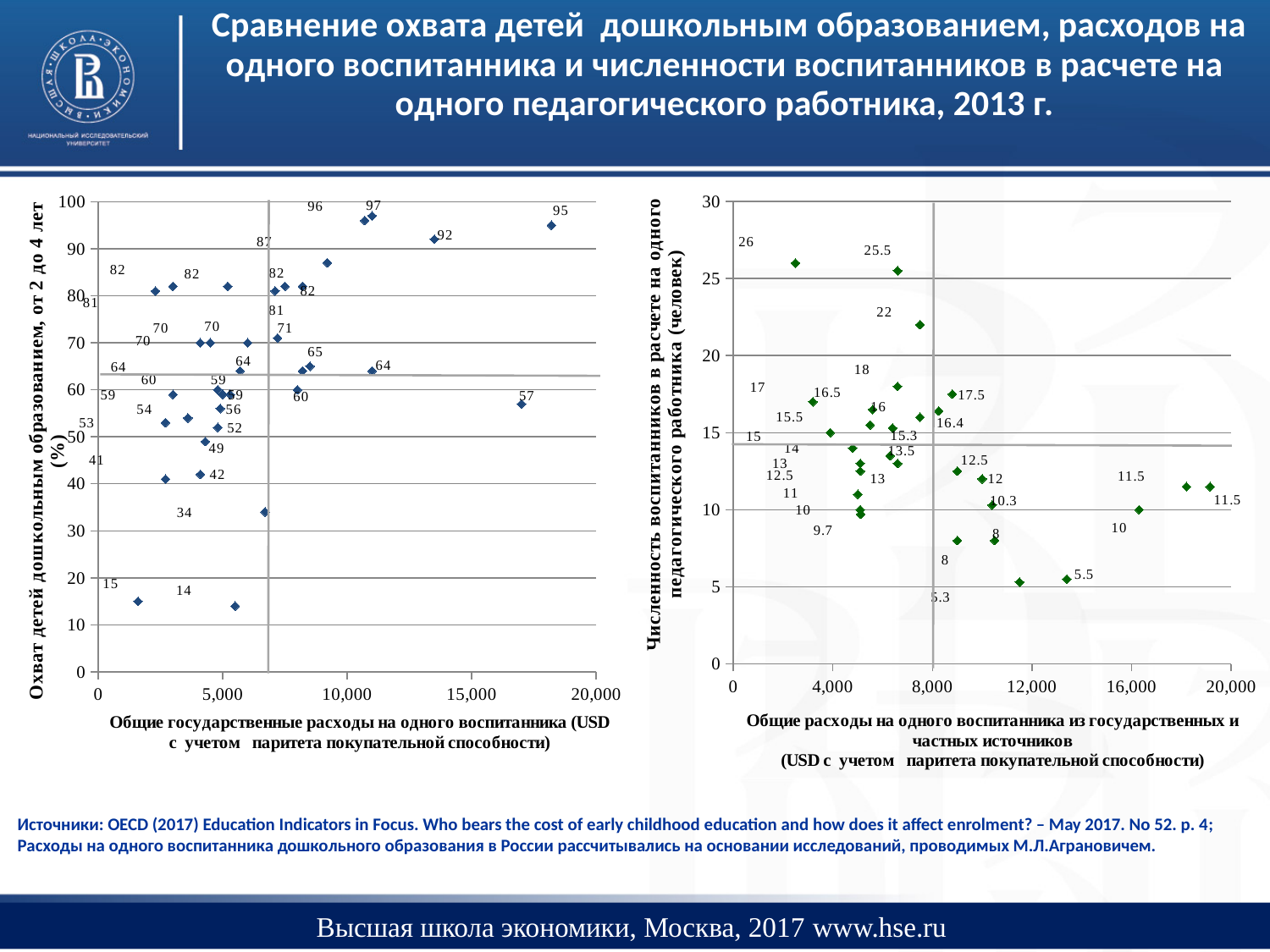
What is the maximum value shown on the vertical axis of the right chart? 30 In the left chart, is the y value of the rightmost point greater or less than 90? greater In the right chart, what is the data label of the point with the largest x value (furthest right)? 11.5 What kind of chart is the left chart on the slide? scatter chart In the left chart, what is the highest data label value shown? 97 In the right chart, is the y value of the rightmost point greater or less than 15? less In the left chart, what is the data label of the point with the largest x value (furthest right)? 95 How many charts are shown on the slide? 2 What kind of chart is the right chart on the slide? scatter chart In the right chart, what is the lowest data label value shown? 5.3 In the right chart, what is the highest data label value shown? 26 In the left chart, what is the lowest data label value shown? 14